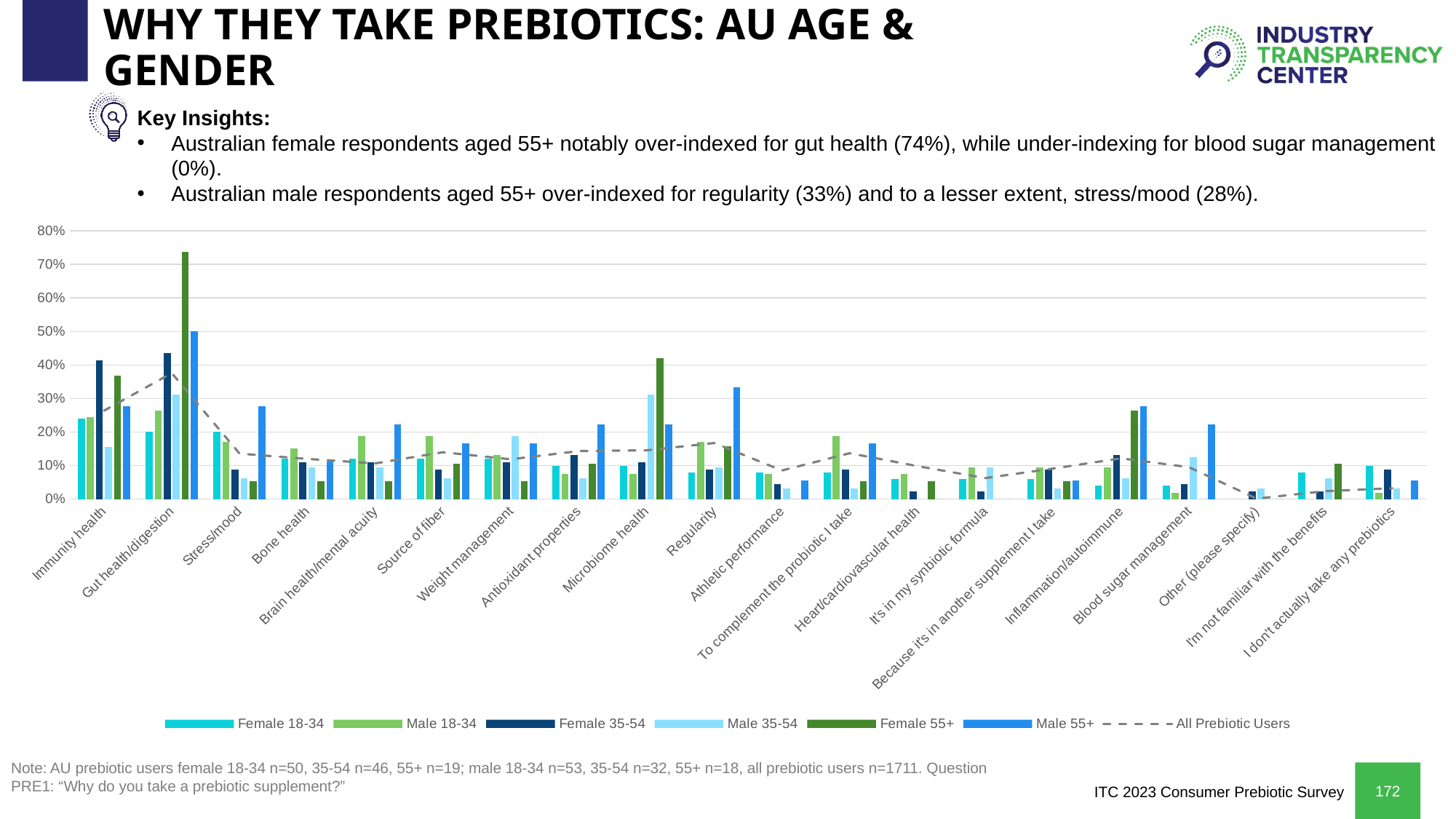
How many series does the chart legend list? 7 Which category has the highest Male 55+ bar? Gut health/digestion Is the Male 55+ value for Regularity greater or less than 20%? greater For Gut health/digestion, which is larger: the Female 55+ value or the Male 55+ value? Female 55+ Which category has the highest Female 55+ bar? Gut health/digestion Which series is drawn as a dashed line rather than bars? All Prebiotic Users What kind of chart is shown on the slide? combination bar and line chart Is the Female 35-54 value for Immunity health greater or less than 30%? greater Is the Female 55+ value for Gut health/digestion greater or less than 60%? greater How many categories are shown along the x axis of the chart? 20 For Immunity health, which is larger: the Female 18-34 value or the Female 35-54 value? Female 35-54